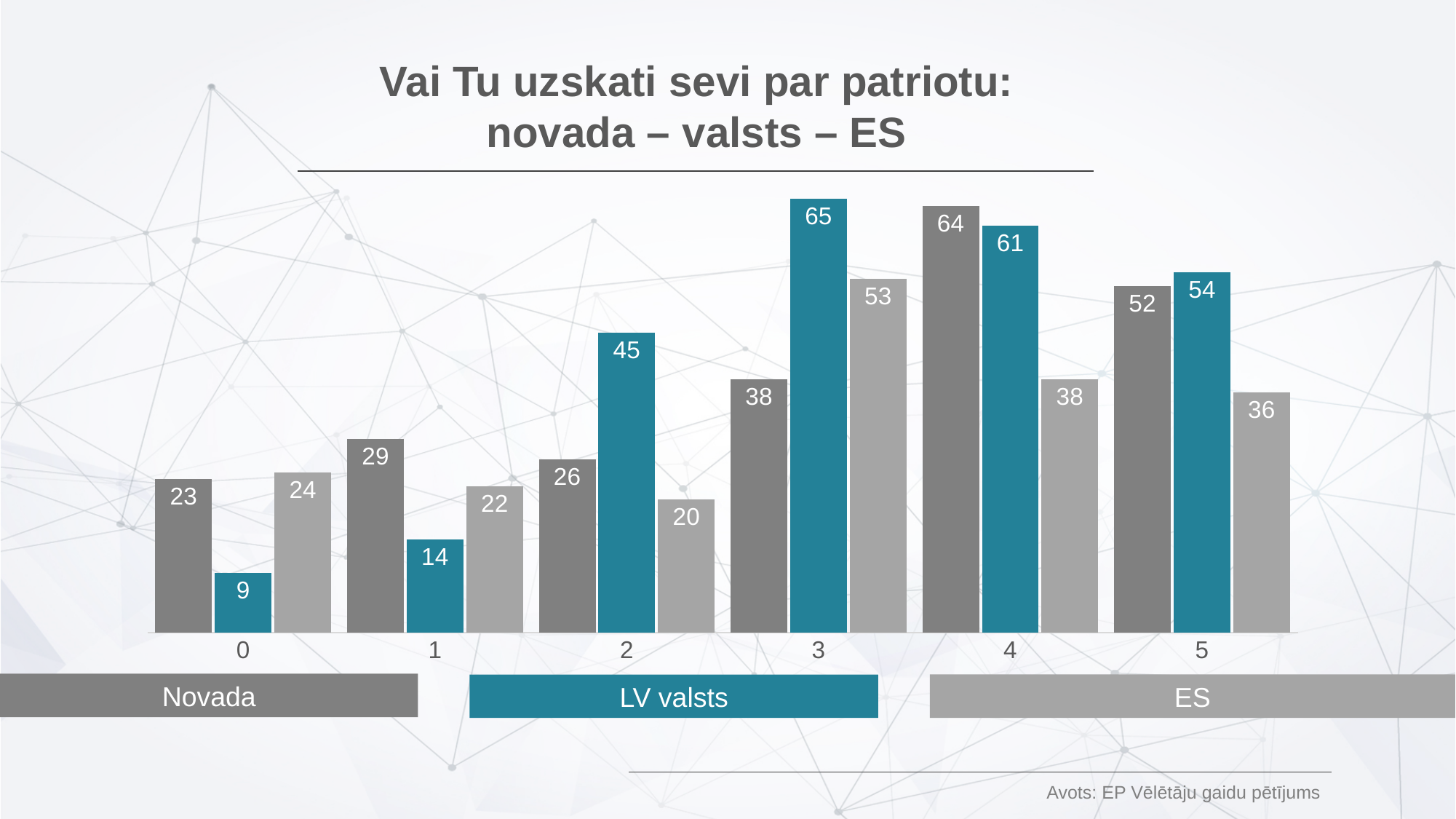
What is the value for ES at category 0? 24 How many series does the legend list? 3 What kind of chart is shown on the slide? bar chart Which category has the lowest value for LV valsts? 0 What is the difference between the LV valsts values at category 3 and category 5? 11 What is the value for Novada at category 4? 64 Which category has the highest value for LV valsts? 3 What is the difference between the Novada and ES values at category 4? 26 How many categories are shown on the x axis? 6 What is the value for LV valsts at category 3? 65 At category 2, which is larger: LV valsts or ES? LV valsts Which series is shown in teal? LV valsts